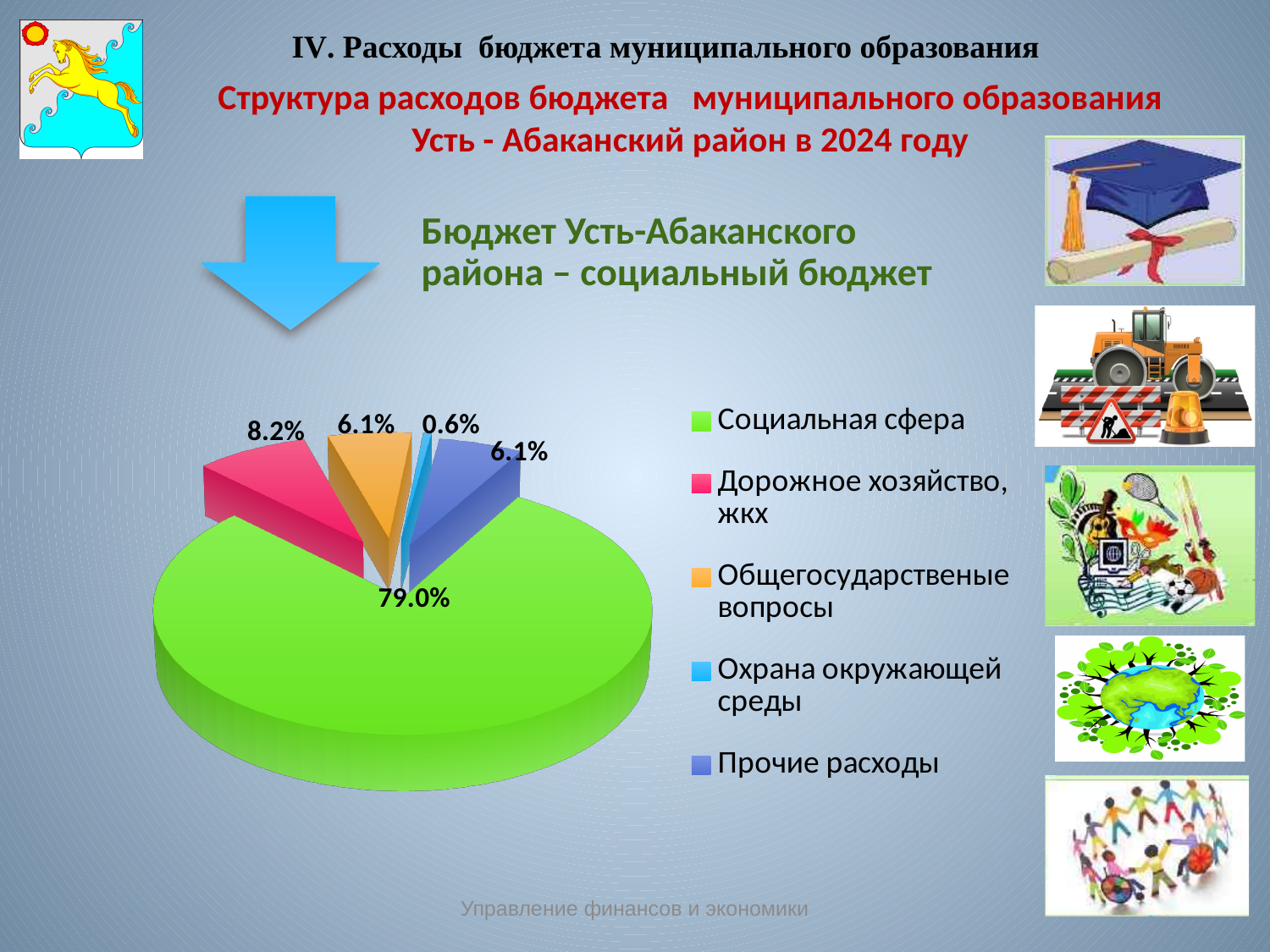
What is the difference between the shares of Общегосударственые вопросы and Охрана окружающей среды? 5.5% How many categories does the legend of the pie chart list? 5 Which category has the largest slice of the pie? Социальная сфера What kind of chart is shown on the slide? pie chart Which category has the smallest slice of the pie? Охрана окружающей среды What share of the pie does Социальная сфера have? 79.0% What is the difference between the shares of Социальная сфера and Дорожное хозяйство, жкх? 70.8% What is the value for Прочие расходы? 6.1% What is the value for Дорожное хозяйство, жкх? 8.2% What is the value for Охрана окружающей среды? 0.6% Which is larger: the share of Дорожное хозяйство, жкх or the share of Общегосударственые вопросы? Дорожное хозяйство, жкх What colour is the slice for Социальная сфера? green